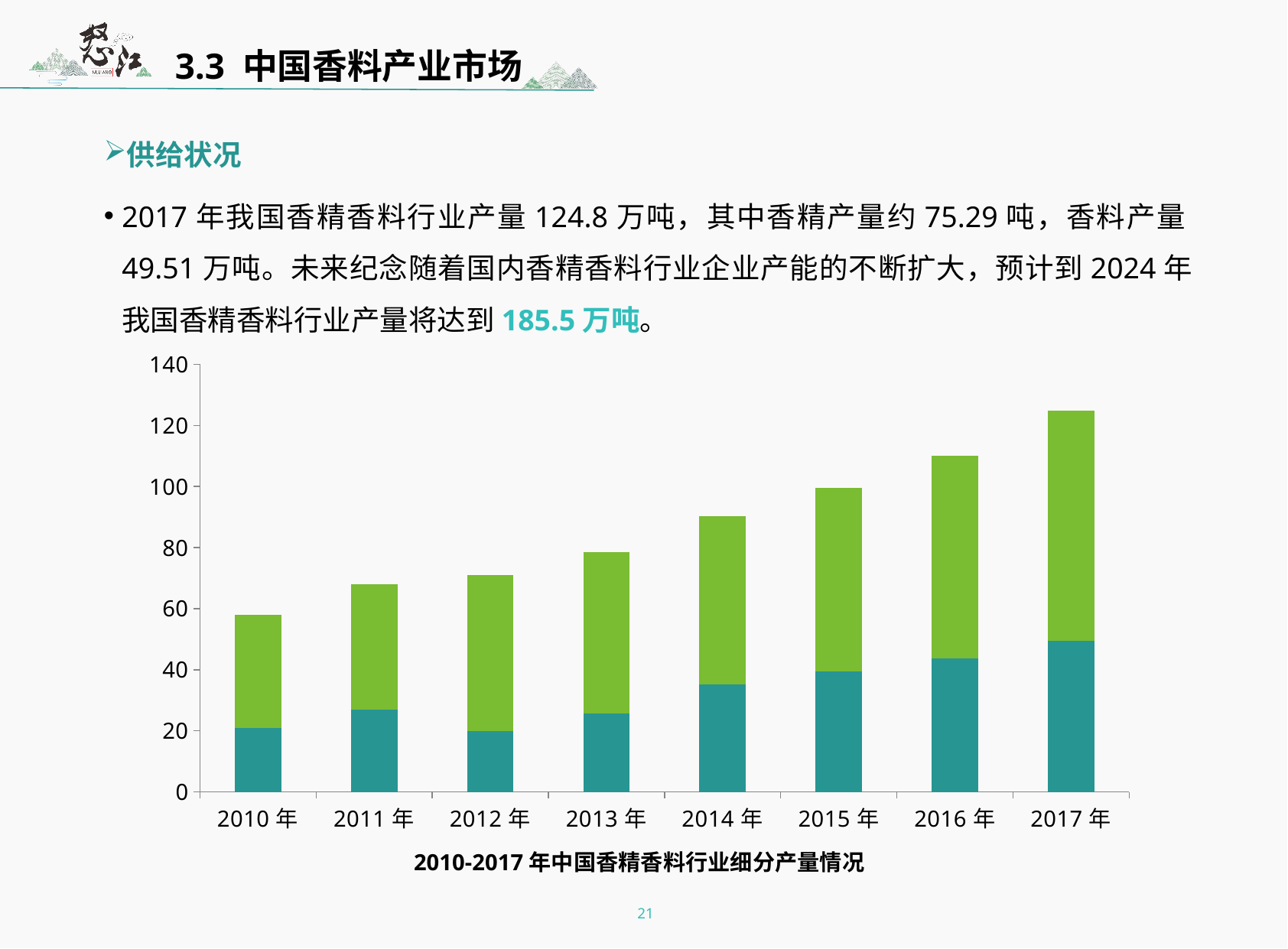
Is the total bar height for 2016 年 greater or less than 100? greater Is the total bar height for 2010 年 greater or less than 40? greater Which year has the tallest stacked bar? 2017 年 Is the total bar height for 2014 年 greater or less than 80? greater What is the title of the chart? 2010-2017 年中国香精香料行业细分产量情况 Do the total bar heights rise or fall from 2010 年 to 2017 年? rise What kind of chart is shown on the slide? stacked bar chart How many years are shown on the x axis of the chart? 8 Which year has the shortest stacked bar? 2010 年 Which year has the larger total bar, 2012 年 or 2015 年? 2015 年